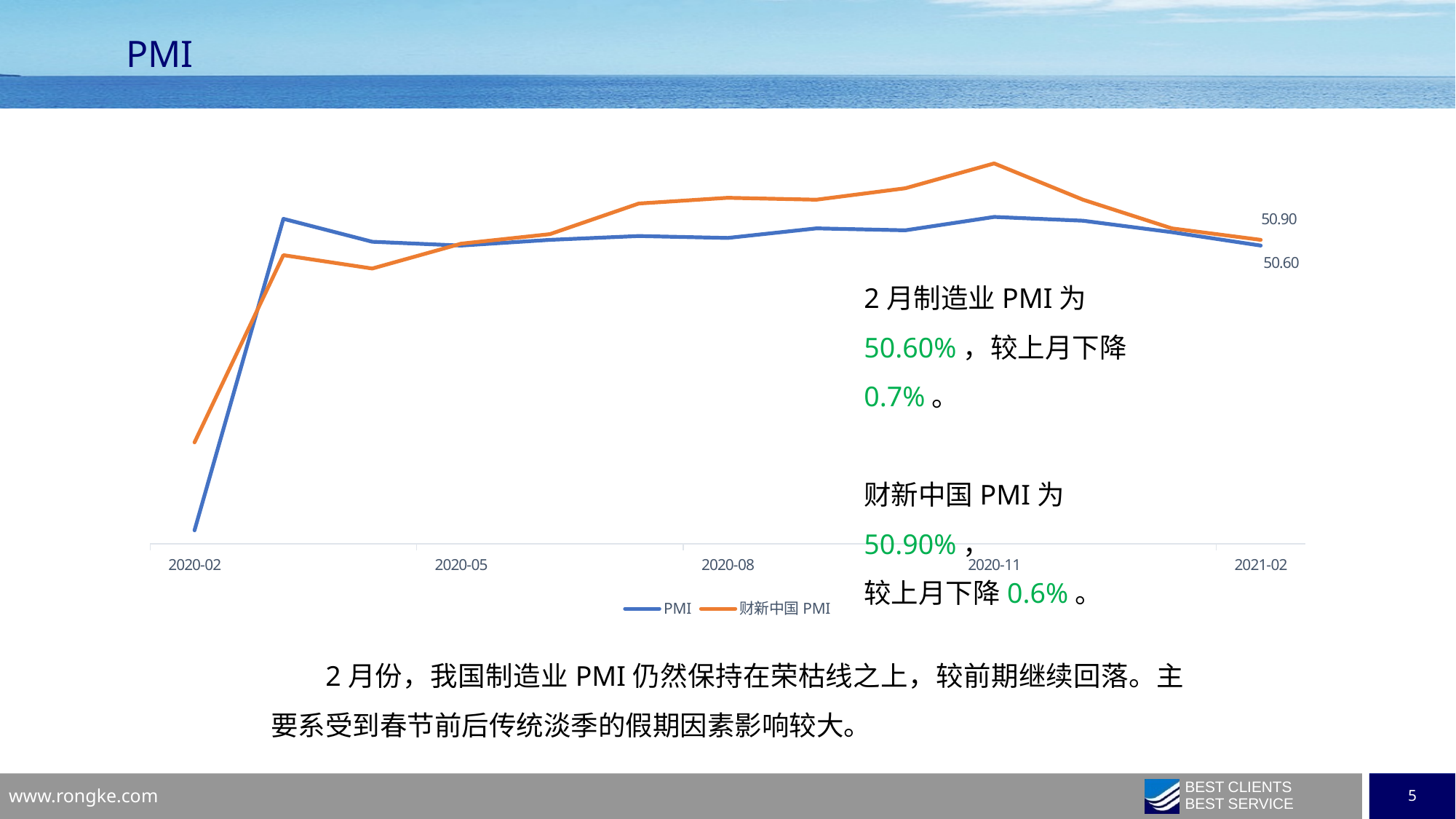
How many series does the chart legend list? 2 What is the value of the 财新中国 PMI series at 2021-02? 50.90 At 2020-02, which series has the higher value, PMI or 财新中国 PMI? 财新中国 PMI Does the 财新中国 PMI series rise or fall between 2020-11 and 2021-02? fall At 2021-02, which series has the higher value, PMI or 财新中国 PMI? 财新中国 PMI At which x-axis date does the PMI series reach its lowest point? 2020-02 What kind of chart is shown on the slide? line chart What is the value of the PMI series at 2021-02? 50.60 What are the two series names listed in the chart legend? PMI and 财新中国 PMI What is the difference between the 财新中国 PMI and PMI values at 2021-02? 0.30 At which x-axis date does the 财新中国 PMI series reach its highest point? 2020-11 What colour is the line for the PMI series? blue